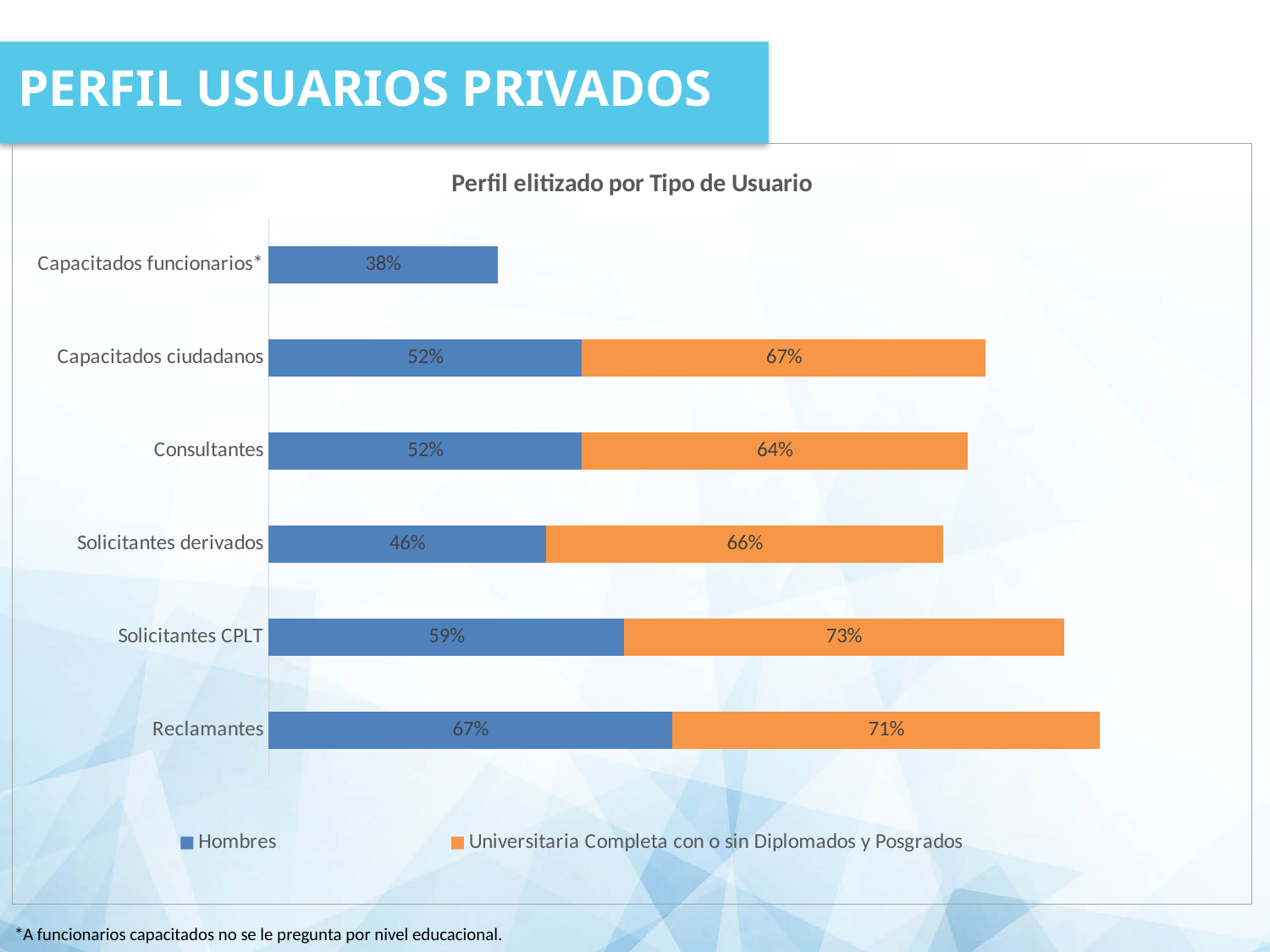
Which category has the lowest Hombres value? Capacitados funcionarios* What is the title of the chart? Perfil elitizado por Tipo de Usuario Which category has the highest Universitaria Completa con o sin Diplomados y Posgrados value? Solicitantes CPLT What is the Hombres value for Solicitantes derivados? 46% How many series does the legend list? 2 What is the Universitaria Completa con o sin Diplomados y Posgrados value for Consultantes? 64% How many categories are shown on the y axis of the chart? 6 Which is larger for Capacitados ciudadanos: the Hombres value or the Universitaria Completa value? Universitaria Completa con o sin Diplomados y Posgrados What kind of chart is shown on the slide? Stacked bar chart What is the Hombres value for Reclamantes? 67% What is the Universitaria Completa con o sin Diplomados y Posgrados value for Solicitantes CPLT? 73% What is the difference between the Universitaria Completa value and the Hombres value for Solicitantes derivados? 20%